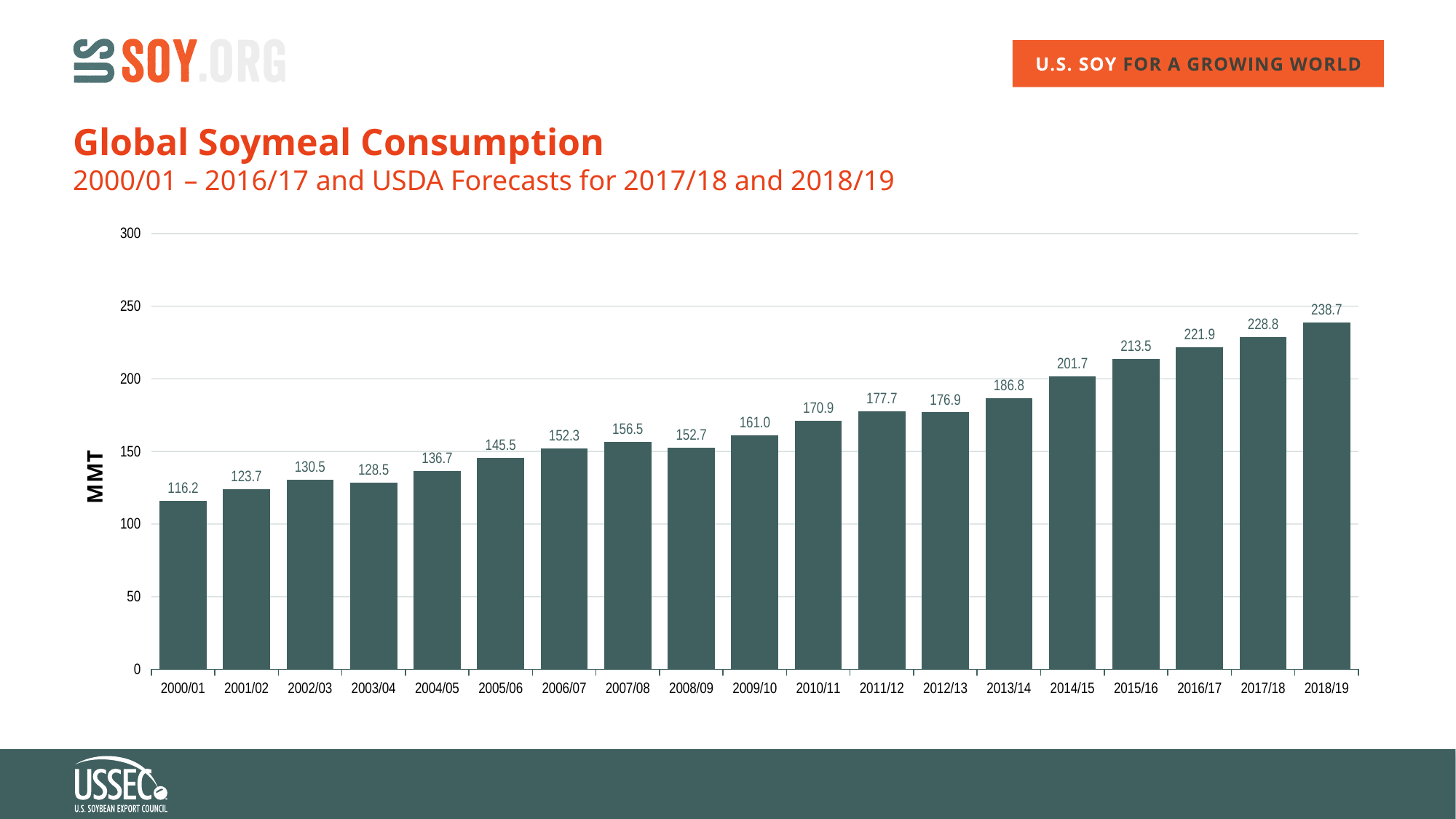
What is the value shown for 2014/15? 201.7 Is the value for 2013/14 greater or less than 200? less What is the difference between the values for 2018/19 and 2017/18? 9.9 Which year has the lowest soymeal consumption? 2000/01 What is the difference between the values for 2007/08 and 2008/09? 3.8 What is the label on the y axis? MMT How many years are shown on the x axis? 19 Which year has the highest soymeal consumption? 2018/19 What is the forecast value for 2018/19? 238.7 What is the global soymeal consumption value for 2000/01? 116.2 Which is larger, the value for 2011/12 or the value for 2012/13? 2011/12 What kind of chart is shown on the slide? bar chart